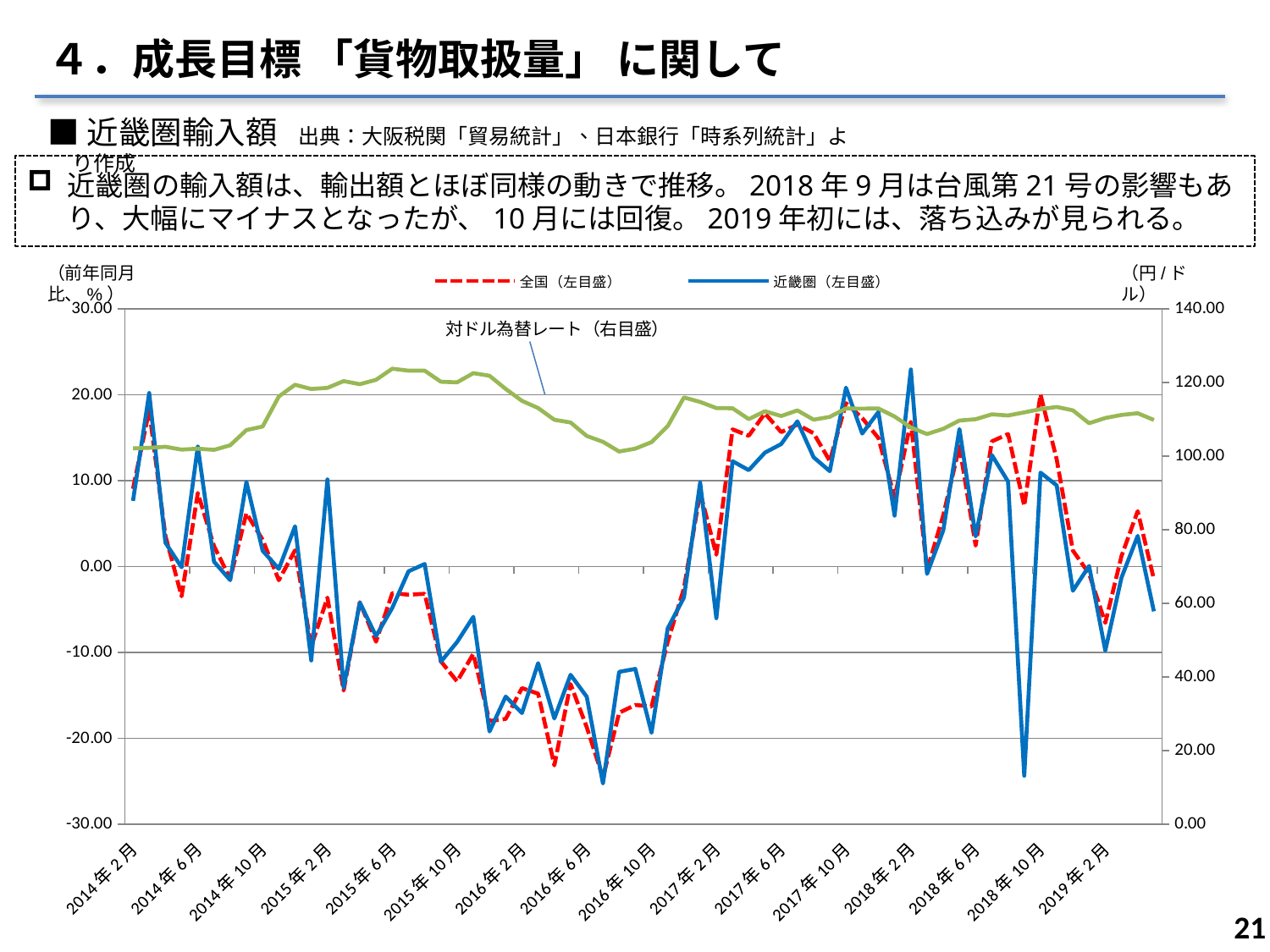
Does the 対ドル為替レート line rise or fall between 2015年6月 and 2016年10月? fall Is the 対ドル為替レート value around 2015年6月 greater or less than 100.00 on the right axis? greater Is the 対ドル為替レート value at 2014年2月 greater or less than 120.00 on the right axis? less Which series is plotted against the right axis? 対ドル為替レート（右目盛） Which series is drawn as a red dashed line? 全国（左目盛） How many month labels are printed along the x axis? 16 What kind of chart is shown on the slide? line chart Is the value of 近畿圏（左目盛） at its deepest dip around 2018年10月 greater or less than -20.00? less How many series does the chart plot (legend entries plus the labelled exchange-rate line)? 3 What is the highest tick value shown on the left axis? 30.00 What is the highest tick value shown on the right axis? 140.00 At the sharp dip around 2018年10月, which series is lower, 全国 or 近畿圏? 近畿圏